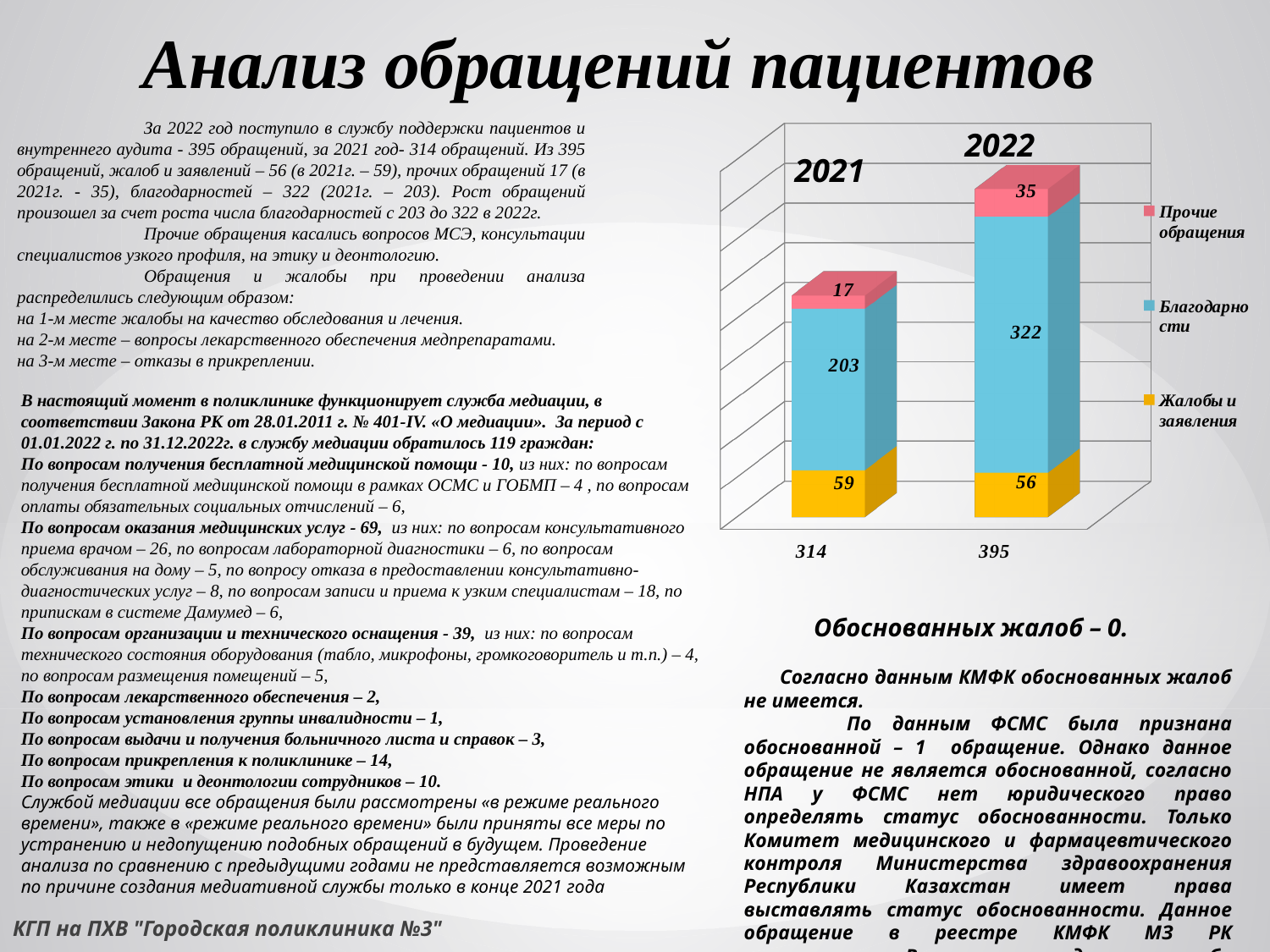
Which series has the highest value in the 2022 bar? Благодарности What is the value of Благодарности for 2022? 322 Which year has the larger value for Прочие обращения, 2021 or 2022? 2022 By how much did Благодарности increase from 2021 to 2022? 119 What is the value of Благодарности for 2021? 203 What kind of chart is shown on the slide? Stacked bar chart What is the value of Прочие обращения for 2022? 35 How many series does the chart legend list? 3 What is the value of Жалобы и заявления for 2021? 59 How many bars (years) are plotted in the chart? 2